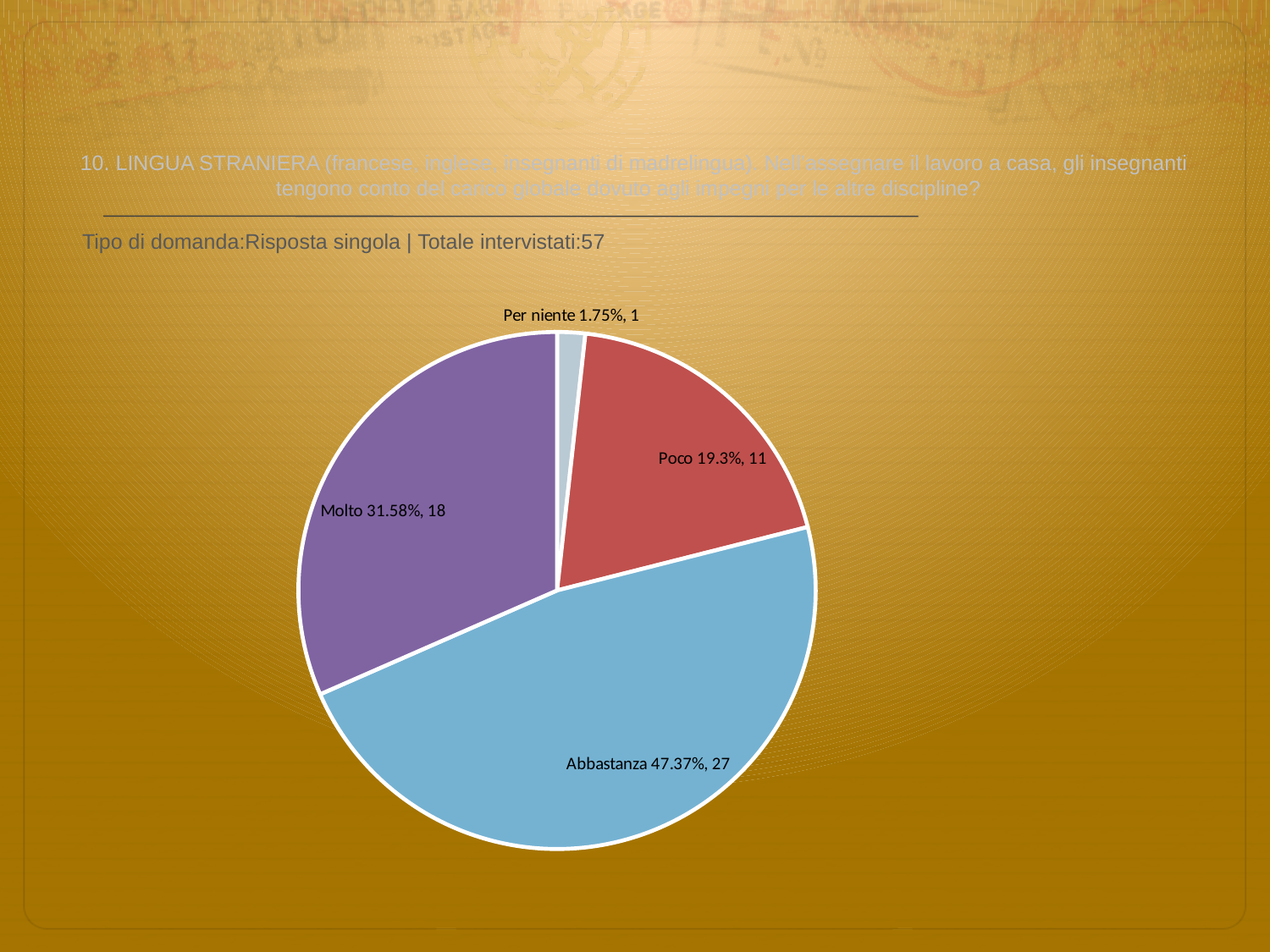
Which category has the largest slice? Abbastanza What is the difference in respondent count between 'Abbastanza' and 'Molto'? 9 What percentage share does the 'Per niente' slice have? 1.75% How many respondents answered 'Molto'? 18 What percentage share does the 'Abbastanza' slice have? 47.37% What colour is the 'Abbastanza' slice? light blue What is the total number of respondents shown on the slide? 57 Which category has the smallest slice? Per niente How many respondents answered 'Poco'? 11 How many slices does the pie chart have? 4 What kind of chart is shown on the slide? pie chart Which has more respondents, 'Poco' or 'Molto'? Molto